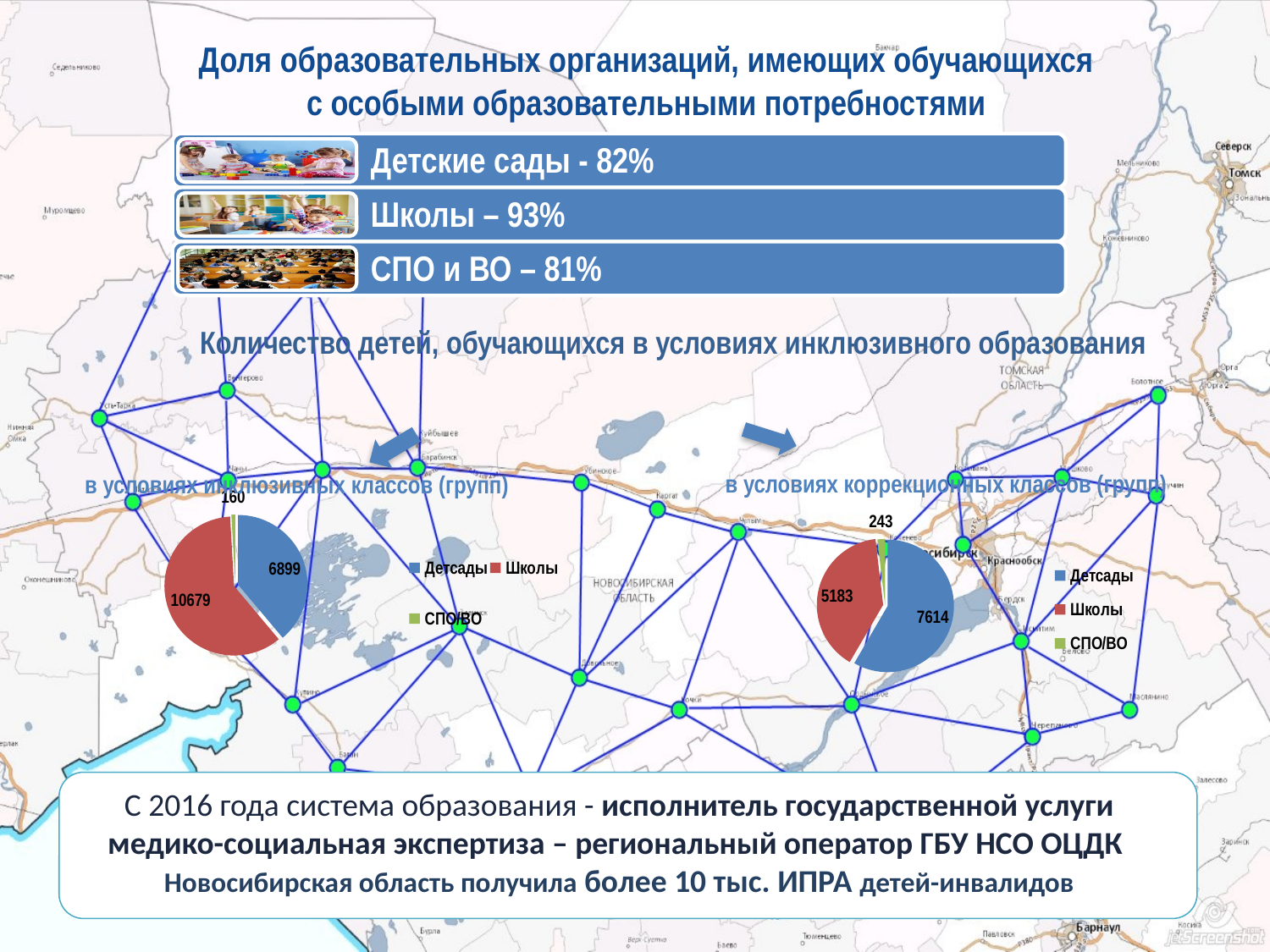
In the left pie chart (в условиях инклюзивных классов (групп)), what is the value for Детсады? 6899 In the right pie chart (в условиях коррекционных классов (групп)), what is the difference between the values for Детсады and Школы? 2431 In the right pie chart (в условиях коррекционных классов (групп)), what is the value for СПО/ВО? 243 In the left pie chart (в условиях инклюзивных классов (групп)), what is the total of all three categories? 17738 What type of chart is used for в условиях коррекционных классов (групп)? Pie chart In the right pie chart (в условиях коррекционных классов (групп)), which category has the smallest value? СПО/ВО In the left pie chart (в условиях инклюзивных классов (групп)), which category has the largest value? Школы How many categories does the left pie chart (в условиях инклюзивных классов (групп)) show? 3 In the right pie chart (в условиях коррекционных классов (групп)), what is the value for Детсады? 7614 In the left pie chart (в условиях инклюзивных классов (групп)), what is the difference between the values for Школы and Детсады? 3780 In the right pie chart (в условиях коррекционных классов (групп)), which is larger: Детсады or Школы? Детсады In the left pie chart (в условиях инклюзивных классов (групп)), what is the value for Школы? 10679